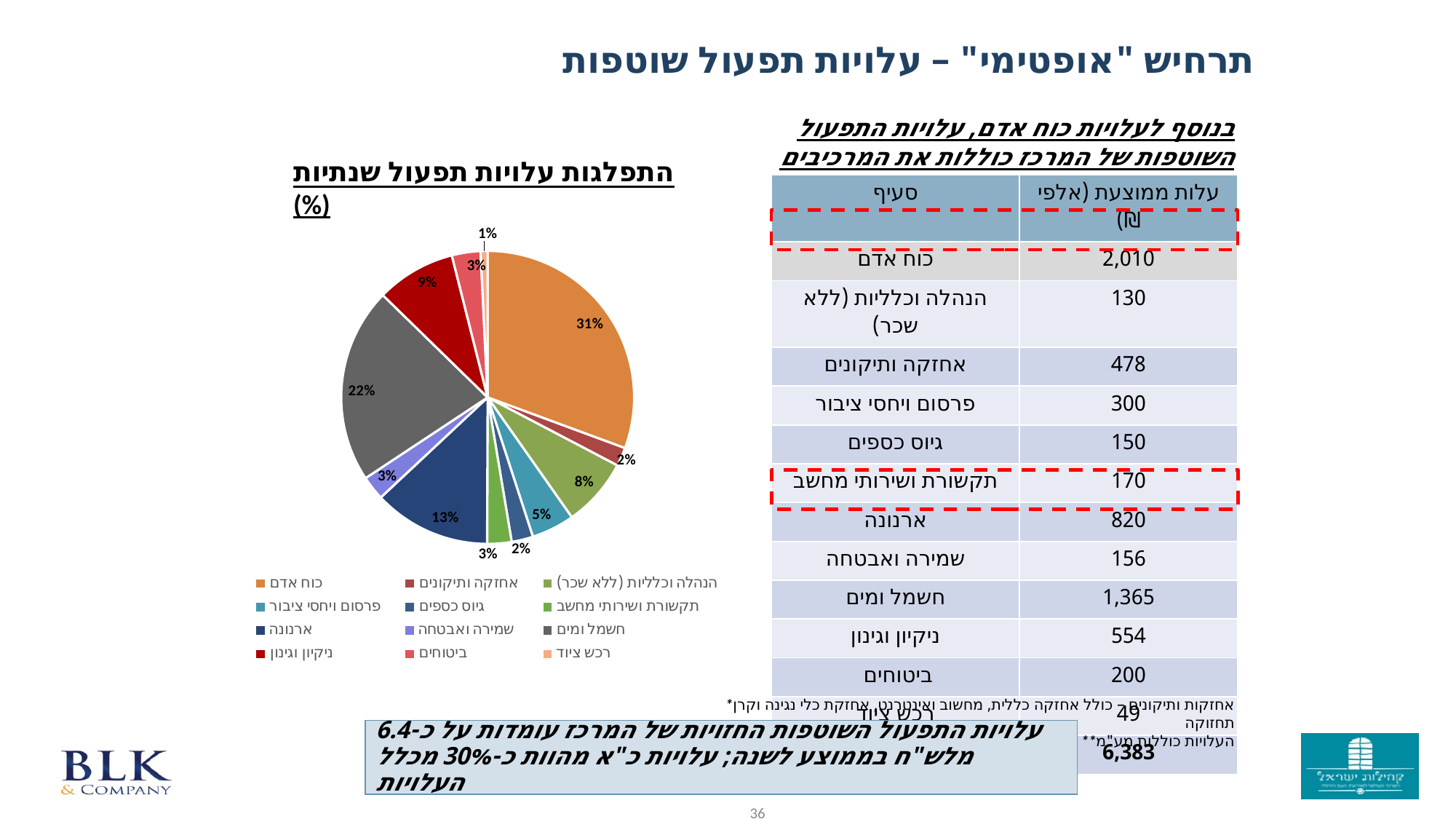
Which category has the smallest slice in the pie chart? רכש ציוד What is the title of the pie chart? התפלגות עלויות תפעול שנתיות (%) What percentage does the pie chart show for ניקיון וגינון? 9% What percentage does the pie chart show for ארנונה? 13% Which slice is larger, ארנונה or ניקיון וגינון? ארנונה What percentage does the pie chart show for רכש ציוד? 1% What kind of chart is shown on the slide? Pie chart What is the difference in percentage points between the כוח אדם slice and the חשמל ומים slice? 9 What percentage does the pie chart show for כוח אדם? 31% How many categories does the pie chart legend list? 12 Which category has the largest slice in the pie chart? כוח אדם What percentage does the pie chart show for חשמל ומים? 22%